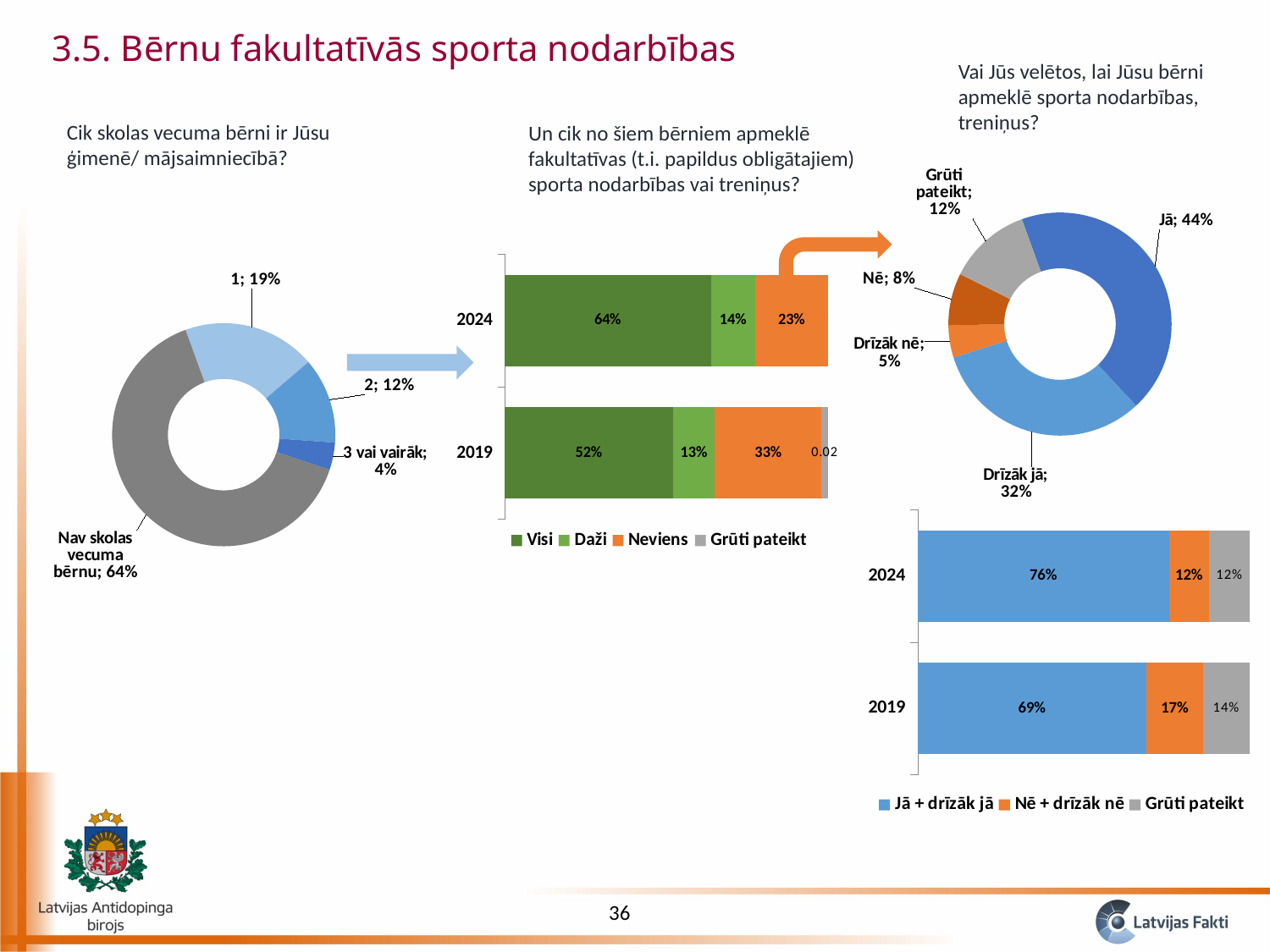
In the middle stacked bar chart ("Un cik no šiem bērniem apmeklē fakultatīvas..."), what is the value for "Visi" in 2024? 64% In the bottom-right stacked bar chart, what is the value for "Jā + drīzāk jā" in 2024? 76% In the right donut chart ("Vai Jūs velētos, lai Jūsu bērni apmeklē sporta nodarbības, treniņus?"), what share answered "Jā"? 44% In the middle stacked bar chart ("Un cik no šiem bērniem apmeklē fakultatīvas..."), by how many percentage points did "Visi" change from 2019 to 2024? 12 percentage points In the left donut chart ("Cik skolas vecuma bērni ir Jūsu ģimenē/ mājsaimniecībā?"), what share is labelled "Nav skolas vecuma bērnu"? 64% In the middle stacked bar chart ("Un cik no šiem bērniem apmeklē fakultatīvas..."), how many series does the legend list? 4 In the right donut chart ("Vai Jūs velētos, lai Jūsu bērni apmeklē sporta nodarbības, treniņus?"), which is larger: "Nē" or "Drīzāk nē"? Nē In the bottom-right stacked bar chart, what is the difference between "Nē + drīzāk nē" in 2019 and 2024? 5 percentage points In the middle stacked bar chart ("Un cik no šiem bērniem apmeklē fakultatīvas..."), what is the value for "Neviens" in 2019? 33% In the left donut chart ("Cik skolas vecuma bērni ir Jūsu ģimenē/ mājsaimniecībā?"), how many slices are there? 4 What type of chart is the bottom-right chart with the years 2024 and 2019? Stacked bar chart In the left donut chart ("Cik skolas vecuma bērni ir Jūsu ģimenē/ mājsaimniecībā?"), which category has the smallest share? 3 vai vairāk